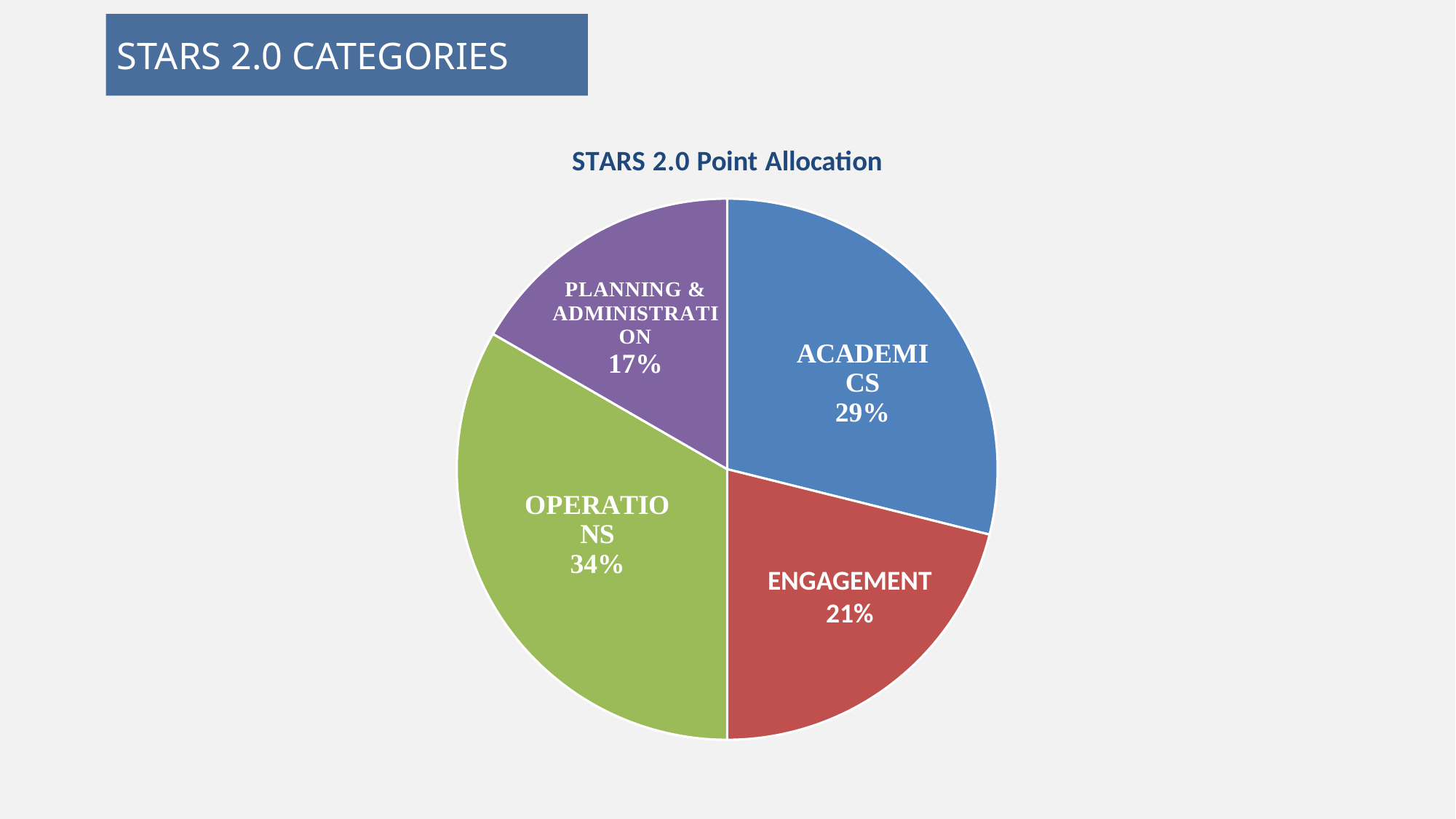
What share of the pie does Academics take? 29% What share of the pie does Operations take? 34% What is the difference in percentage points between Operations and Academics? 5 Which category has the largest share of the pie? Operations How many categories are shown in the pie chart? 4 Which is larger, the share for Academics or the share for Engagement? Academics What share of the pie does Engagement take? 21% What kind of chart is shown on the slide? Pie chart What is the difference in percentage points between Engagement and Planning & Administration? 4 What is the title of the chart? STARS 2.0 Point Allocation Which category has the smallest share of the pie? Planning & Administration